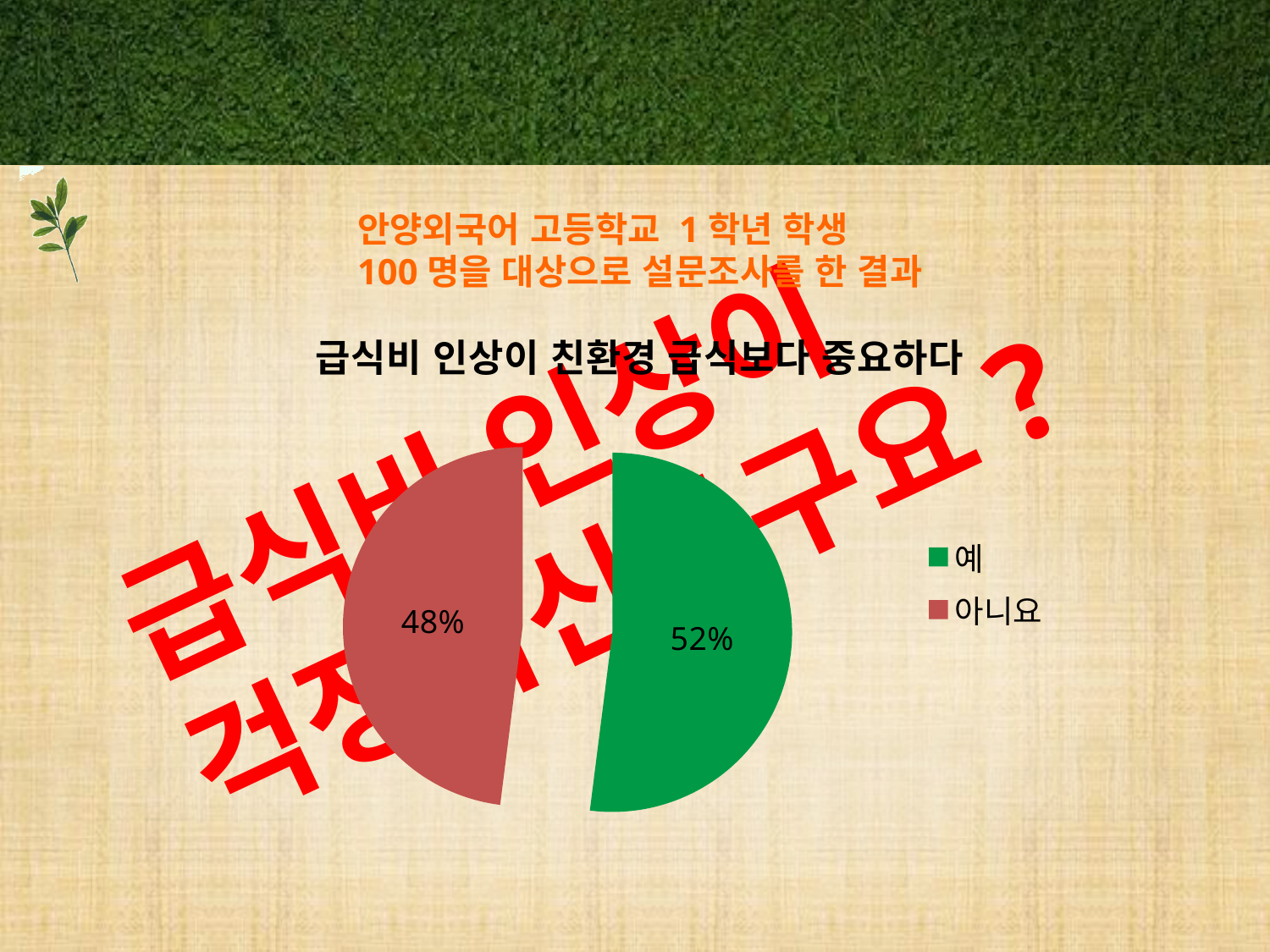
What colour is the 예 slice in the pie chart? green What is the difference between the 예 and 아니요 slices? 4% What is the title of the chart? 급식비 인상이 친환경 급식보다 중요하다 How many entries does the legend list? 2 Which slice of the pie is the largest? 예 What percentage of the pie is labelled 아니요? 48% Which slice of the pie is the smallest? 아니요 Is the value for 아니요 greater or less than 50%? less Which is larger, the 예 slice or the 아니요 slice? 예 How many slices does the pie chart have? 2 What percentage of the pie is labelled 예? 52% What kind of chart is shown on the slide? pie chart